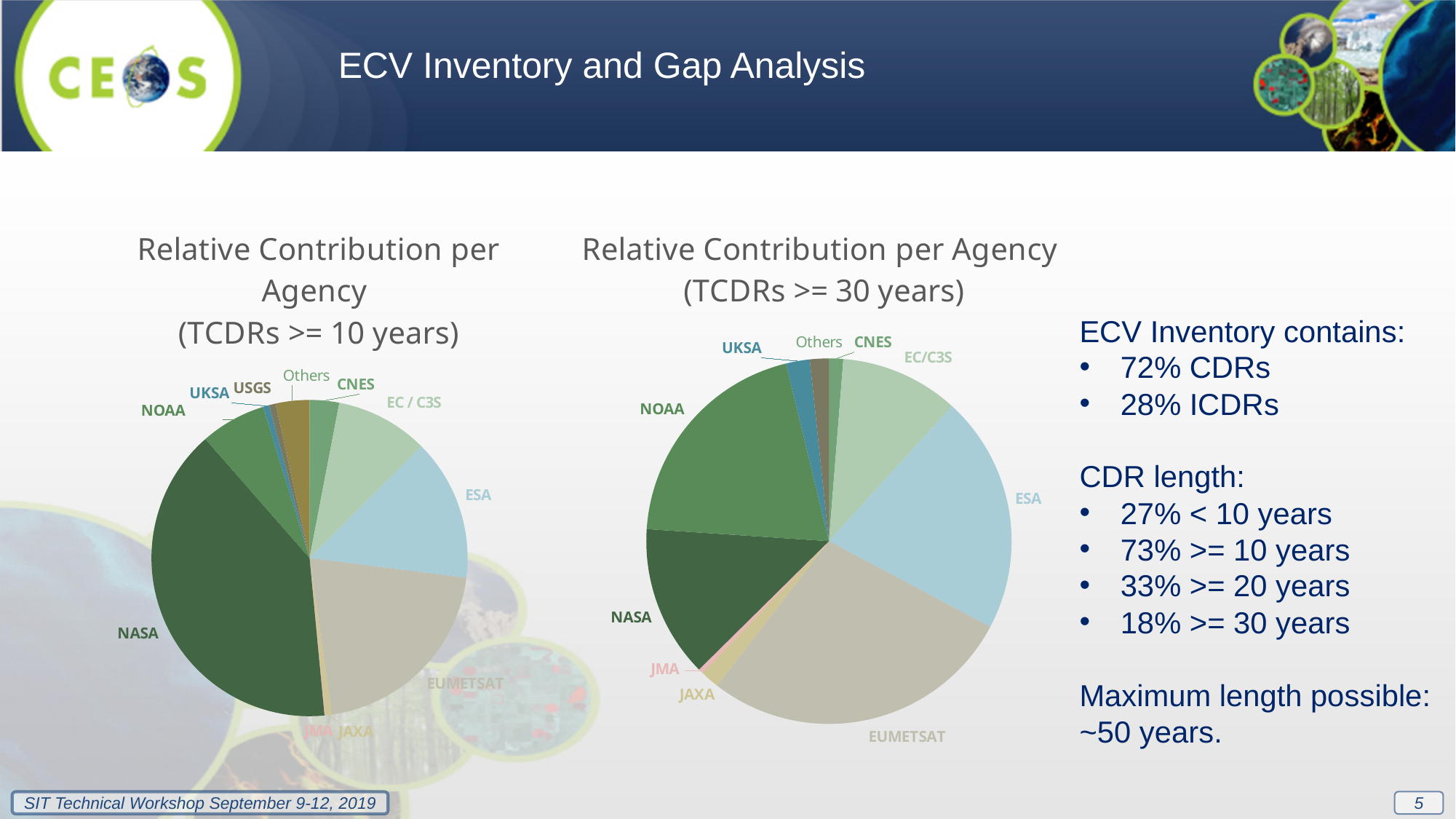
How many labelled slices does the right chart (TCDRs >= 30 years) have? 10 In the right chart (TCDRs >= 30 years), which slice is larger, NOAA or NASA? NOAA In the left chart (TCDRs >= 10 years), which slice is larger, ESA or CNES? ESA What type of chart is the left chart titled 'Relative Contribution per Agency (TCDRs >= 10 years)'? Pie chart What is the title of the right pie chart? Relative Contribution per Agency (TCDRs >= 30 years) In the right chart (TCDRs >= 30 years), which agency has the largest slice? EUMETSAT What type of chart is the right chart titled 'Relative Contribution per Agency (TCDRs >= 30 years)'? Pie chart In the right chart (TCDRs >= 30 years), which slice is larger, EUMETSAT or ESA? EUMETSAT In the left chart (TCDRs >= 10 years), which agency has the largest slice? NASA How many labelled slices does the left chart (TCDRs >= 10 years) have? 11